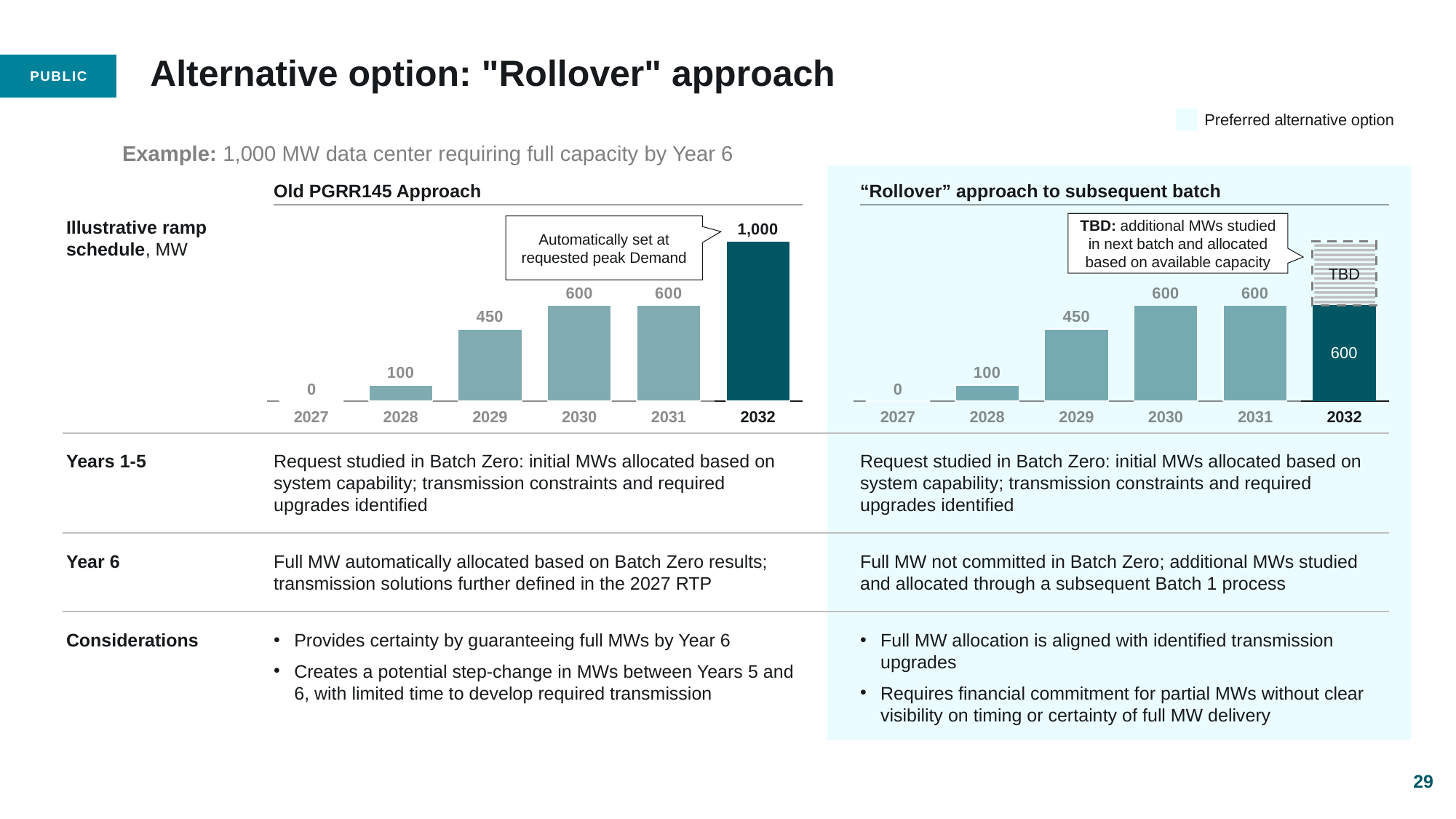
In the "Old PGRR145 Approach" chart, what is the value for 2028? 100 In the "Old PGRR145 Approach" chart, what is the value for 2032? 1,000 In the "Rollover" approach chart, what label is shown on the hatched portion of the 2032 bar? TBD In the "Rollover" approach chart, is the value for 2029 larger or smaller than the value for 2028? Larger In the "Old PGRR145 Approach" chart, do the values rise or fall from 2027 to 2032? Rise In the "Old PGRR145 Approach" chart, what is the value for 2029? 450 In the "Rollover" approach chart, what is the labelled value of the solid portion of the 2032 bar? 600 In the "Old PGRR145 Approach" chart, what is the difference between the 2032 value and the 2031 value? 400 In the "Old PGRR145 Approach" chart, how many years are shown on the x axis? 6 In the "Old PGRR145 Approach" chart, which year has the lowest value? 2027 What kind of chart is the "Old PGRR145 Approach" chart? Bar chart In the "Old PGRR145 Approach" chart, which year has the highest value? 2032